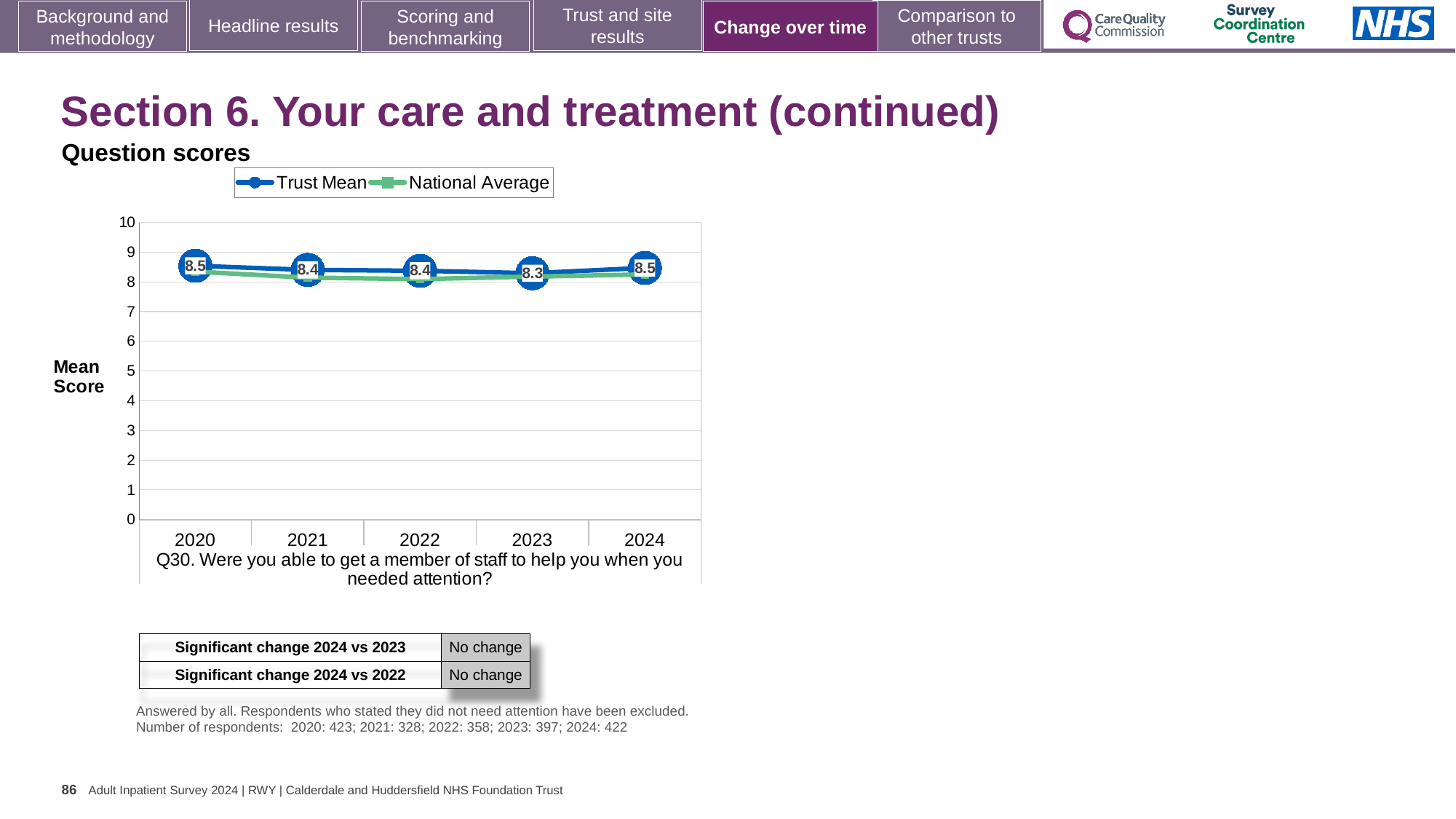
Does the Trust Mean score rise or fall from 2020 to 2023? fall In which year is the Trust Mean score lowest? 2023 What are the two series named in the legend? Trust Mean and National Average Is the National Average value for 2021 greater or less than 5? greater What kind of chart is shown on the slide? line chart What is the Trust Mean score for 2020? 8.5 What is the difference between the Trust Mean scores for 2024 and 2023? 0.2 How many series does the legend list? 2 What is the Trust Mean score for 2024? 8.5 Which year has the larger Trust Mean score, 2020 or 2023? 2020 What is the Trust Mean score for 2023? 8.3 How many years are plotted on the x axis? 5